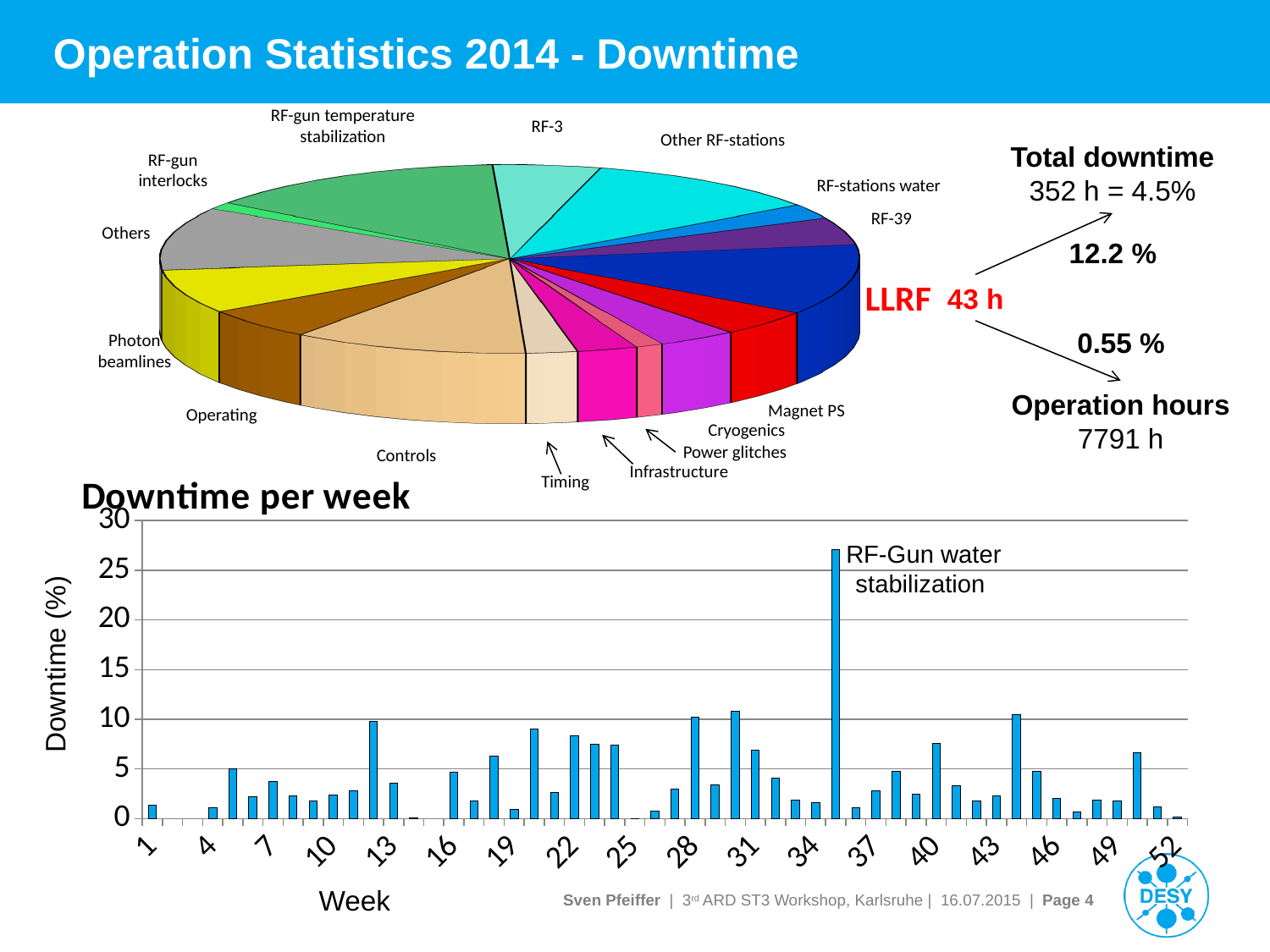
In the 'Downtime per week' bar chart, is the value for week 18 greater or less than 5? greater In the 'Downtime per week' bar chart, is the value for week 20 greater or less than 10? less What kind of chart is the 'Downtime per week' chart at the bottom of the slide? bar chart In the pie chart at the top of the slide, what downtime value is printed for LLRF? 43 h In the 'Downtime per week' bar chart, which has the larger downtime, week 12 or week 1? Week 12 In the 'Downtime per week' bar chart, what is the last week shown on the x axis? 52 In the 'Downtime per week' bar chart, is the value for week 36 greater or less than 25? less In the 'Downtime per week' bar chart, which week has the highest downtime? Week 35 In the 'Downtime per week' bar chart, what cause is annotated next to the tallest bar? RF-Gun water stabilization In the 'Downtime per week' bar chart, which has the larger downtime, week 36 or week 12? Week 12 In the 'Downtime per week' bar chart, what is the label of the y axis? Downtime (%)